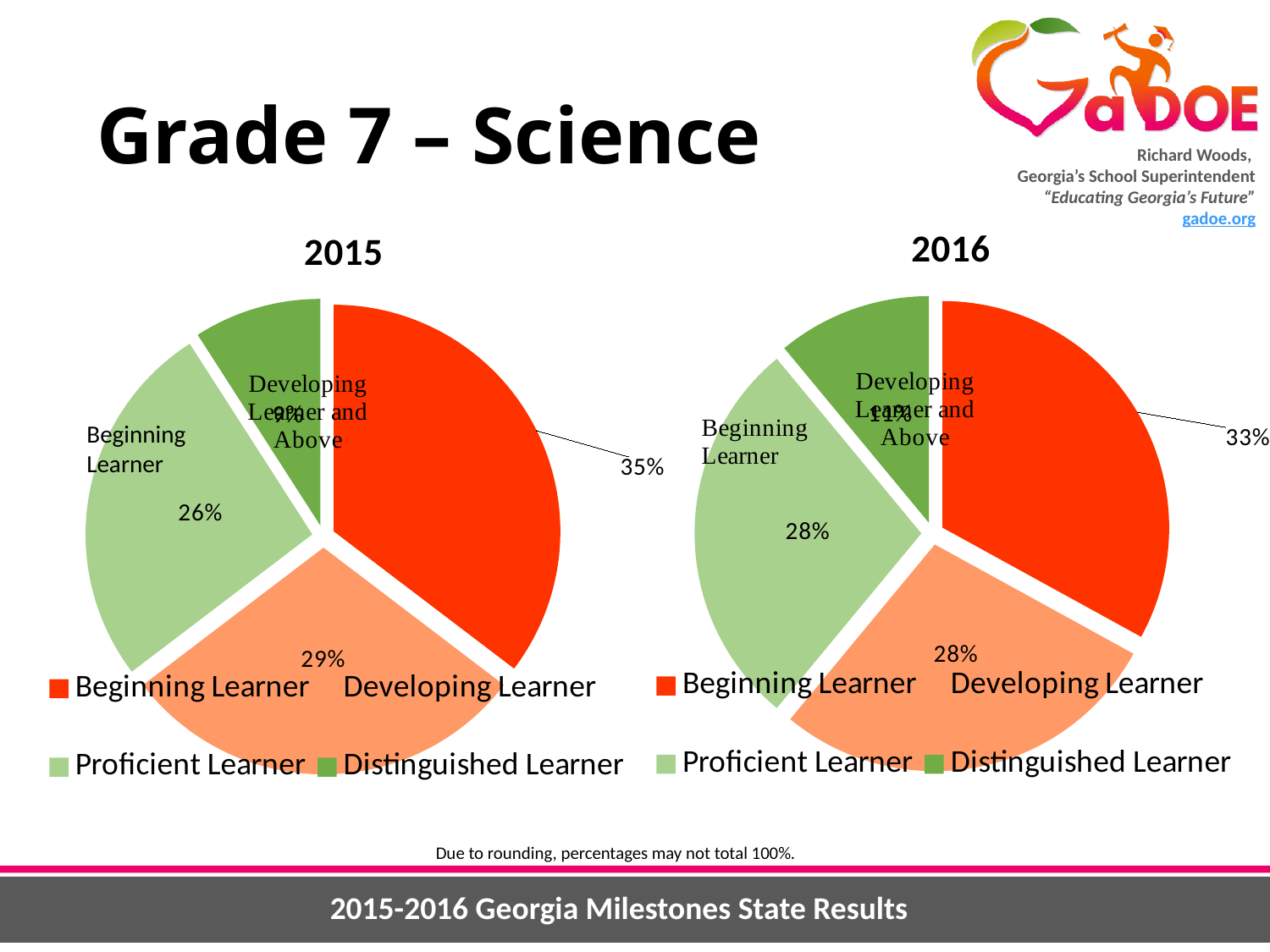
In the 2016 chart, what percentage is shown for Proficient Learner? 28% In the 2016 chart, what percentage is shown for Developing Learner? 28% In the 2015 chart, what percentage is shown for Proficient Learner? 26% In the 2015 chart, which category has the largest slice? Beginning Learner In the 2016 chart, what percentage is shown for Beginning Learner? 33% What kind of chart is the 2015 chart? pie chart In the 2015 chart, what percentage is shown for Developing Learner? 29% In the 2016 chart, which category has the smallest slice? Distinguished Learner Is the Beginning Learner share larger in the 2015 chart or the 2016 chart? 2015 In the 2015 chart, what is the difference in percentage points between Beginning Learner and Developing Learner? 6 How many categories does the legend of the 2016 chart list? 4 In the 2015 chart, what percentage is shown for Beginning Learner? 35%